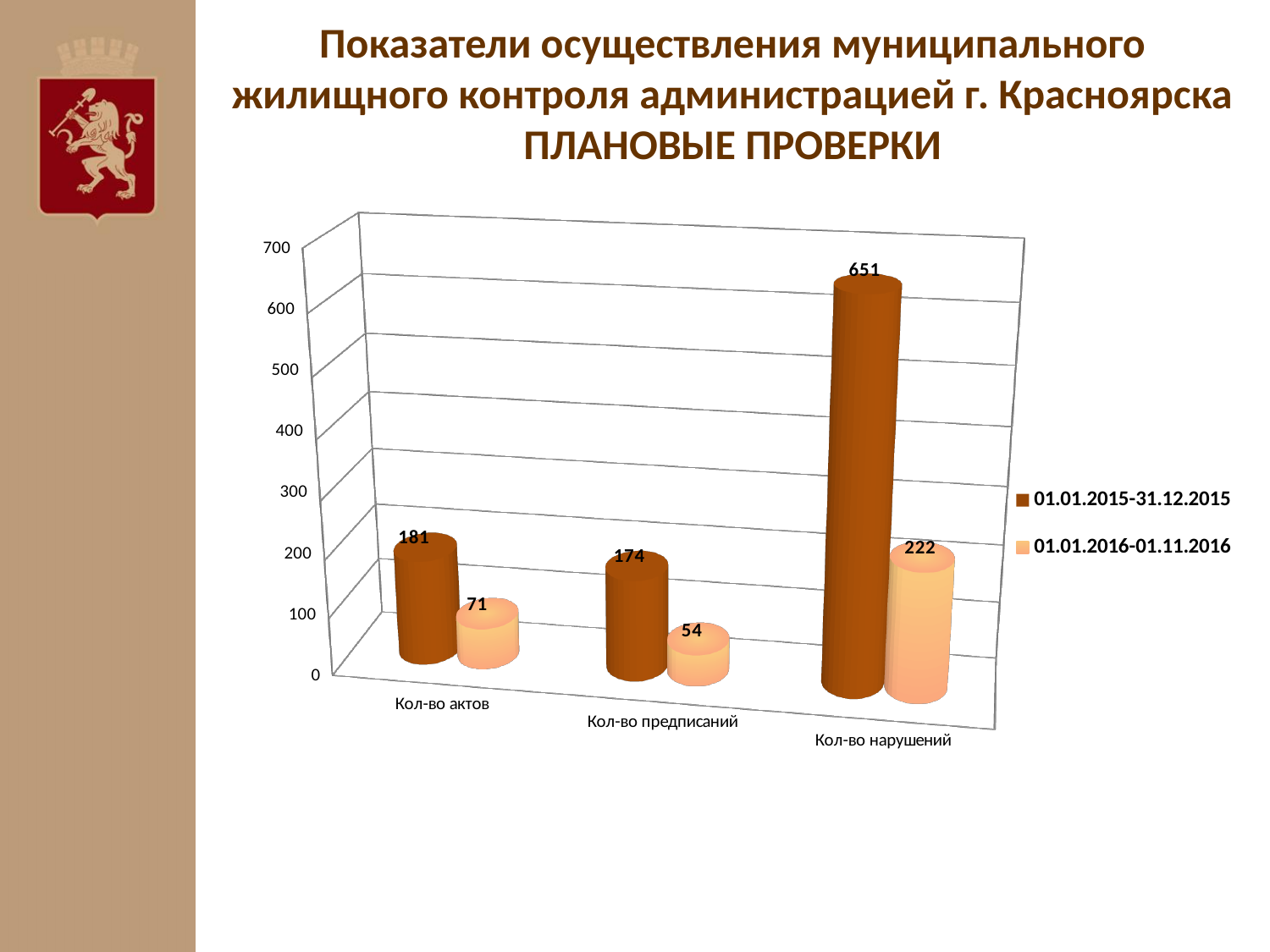
How many categories are shown on the x axis? 3 What kind of chart is shown on the slide? bar chart What is the difference between the 01.01.2015-31.12.2015 and 01.01.2016-01.11.2016 values for Кол-во нарушений? 429 What is the value for Кол-во предписаний in the 01.01.2015-31.12.2015 series? 174 Is the 01.01.2015-31.12.2015 value for Кол-во нарушений greater or less than 600? greater What is the value for Кол-во нарушений in the 01.01.2016-01.11.2016 series? 222 Which category has the lowest value in the 01.01.2016-01.11.2016 series? Кол-во предписаний Which category has the highest value in the 01.01.2015-31.12.2015 series? Кол-во нарушений What is the difference between the 01.01.2015-31.12.2015 and 01.01.2016-01.11.2016 values for Кол-во актов? 110 How many series does the legend list? 2 Which is larger: the 01.01.2016-01.11.2016 value for Кол-во актов or for Кол-во предписаний? Кол-во актов What is the value for Кол-во актов in the 01.01.2015-31.12.2015 series? 181